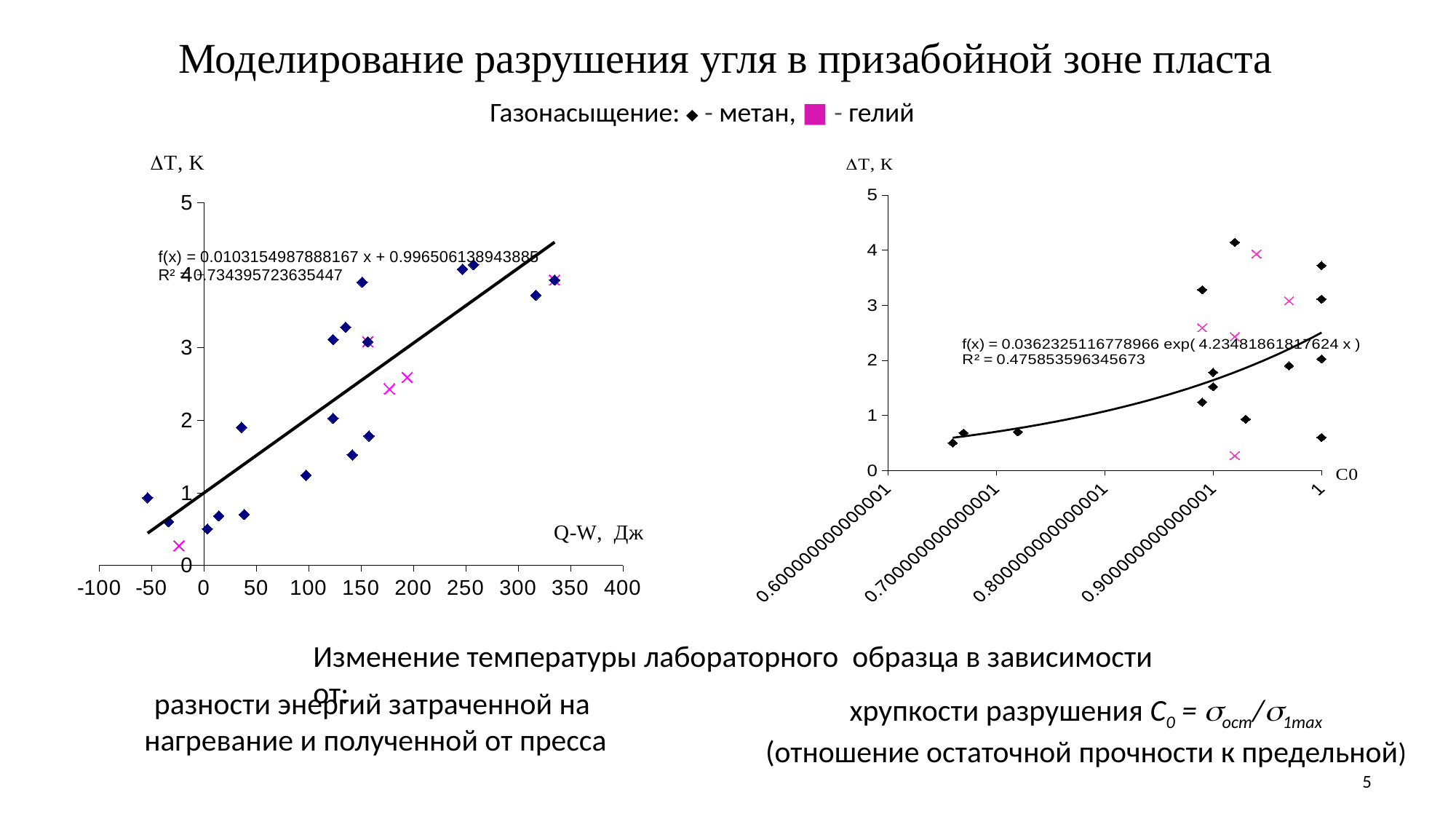
On the left chart, does the fitted trend line rise or fall as Q-W increases? rise On the left chart, is the highest plotted ΔT value greater or less than 3? greater What R² value is printed on the left chart? 0.734395723635447 On the right chart, is the lowest plotted ΔT value greater or less than 1? less What R² value is printed on the right chart? 0.475853596345673 How many series does the legend (Газонасыщение) list for the charts? 2 What kind of chart is the left chart (ΔT, K versus Q-W, Дж)? scatter chart What kind of chart is the right chart (ΔT, K versus C0)? scatter chart On the right chart, does the fitted trend line rise or fall as C0 increases? rise On the right chart, is the highest plotted ΔT value greater or less than 3? greater